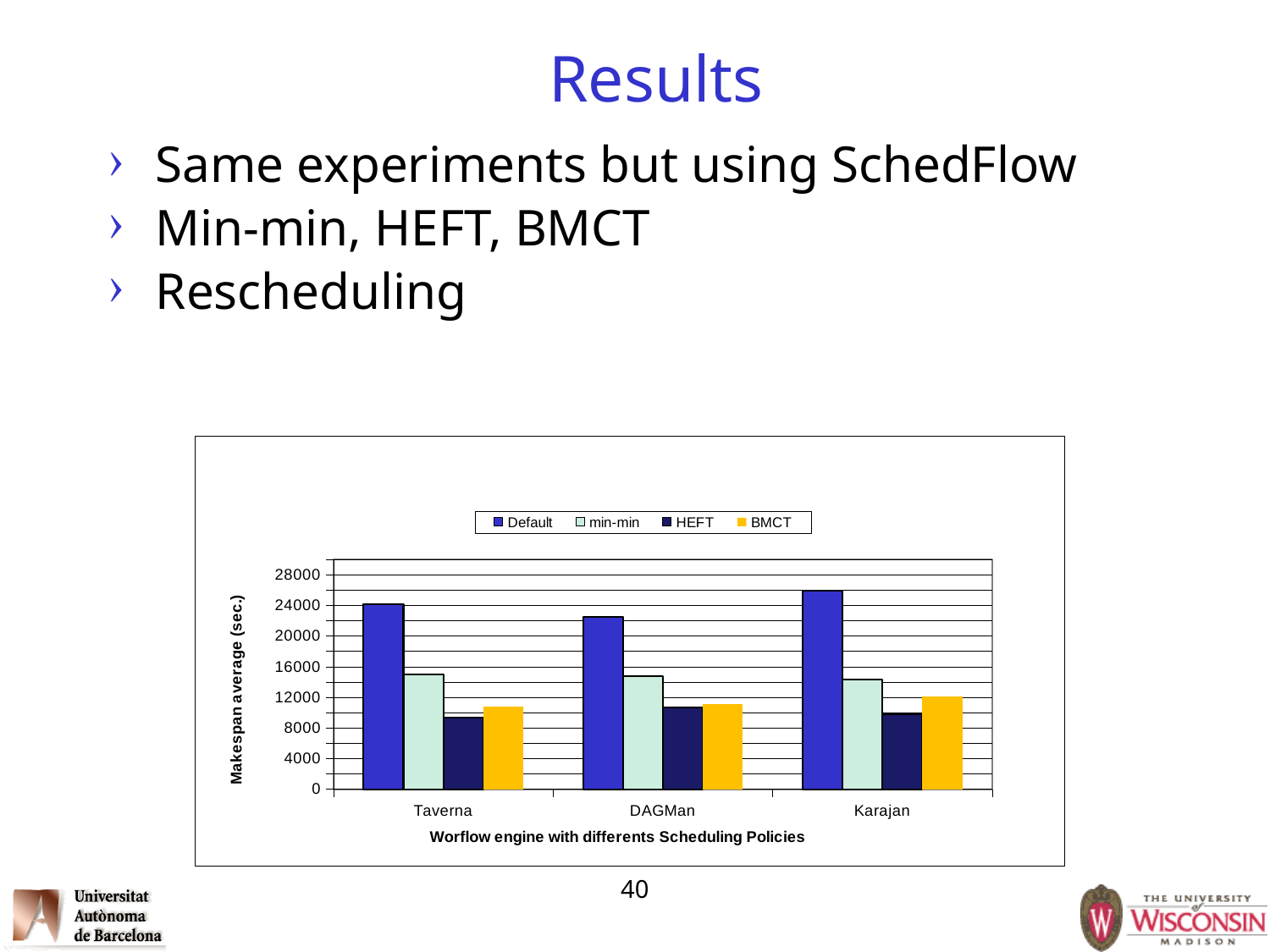
Which workflow engine has the lowest Default makespan average? DAGMan Is the Default value for Karajan greater or less than 24000? greater What kind of chart is shown on the slide? bar chart For Karajan, which is larger: the BMCT value or the HEFT value? BMCT Is the Default value for Taverna greater or less than 20000? greater Is the HEFT value for Taverna greater or less than 12000? less How many workflow engines are shown on the x axis? 3 For Taverna, which is larger: the Default value or the min-min value? Default Which workflow engine has the highest Default makespan average? Karajan What is the title of the y axis? Makespan average (sec.) How many series does the legend list? 4